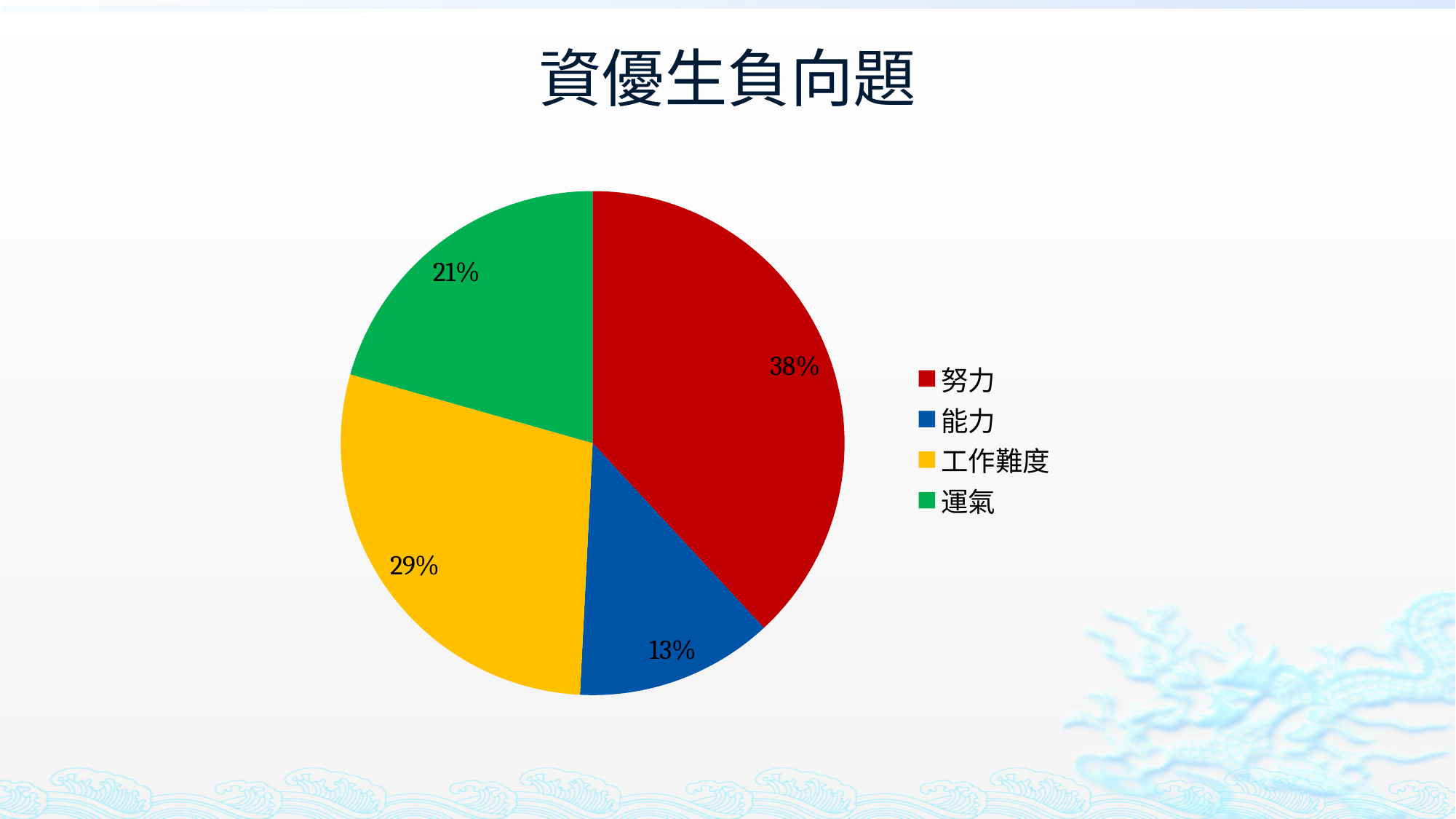
Which category has the largest slice? 努力 What is the difference between the shares for 工作難度 and 運氣? 8% What type of chart is shown on the slide? Pie chart What is the title of the slide? 資優生負向題 What is the share for 努力? 38% What is the share for 工作難度? 29% What is the difference between the shares for 努力 and 能力? 25% Which is larger, the share for 工作難度 or the share for 運氣? 工作難度 What is the share for 能力? 13% What is the share for 運氣? 21% How many categories does the pie chart have? 4 Which category has the smallest slice? 能力